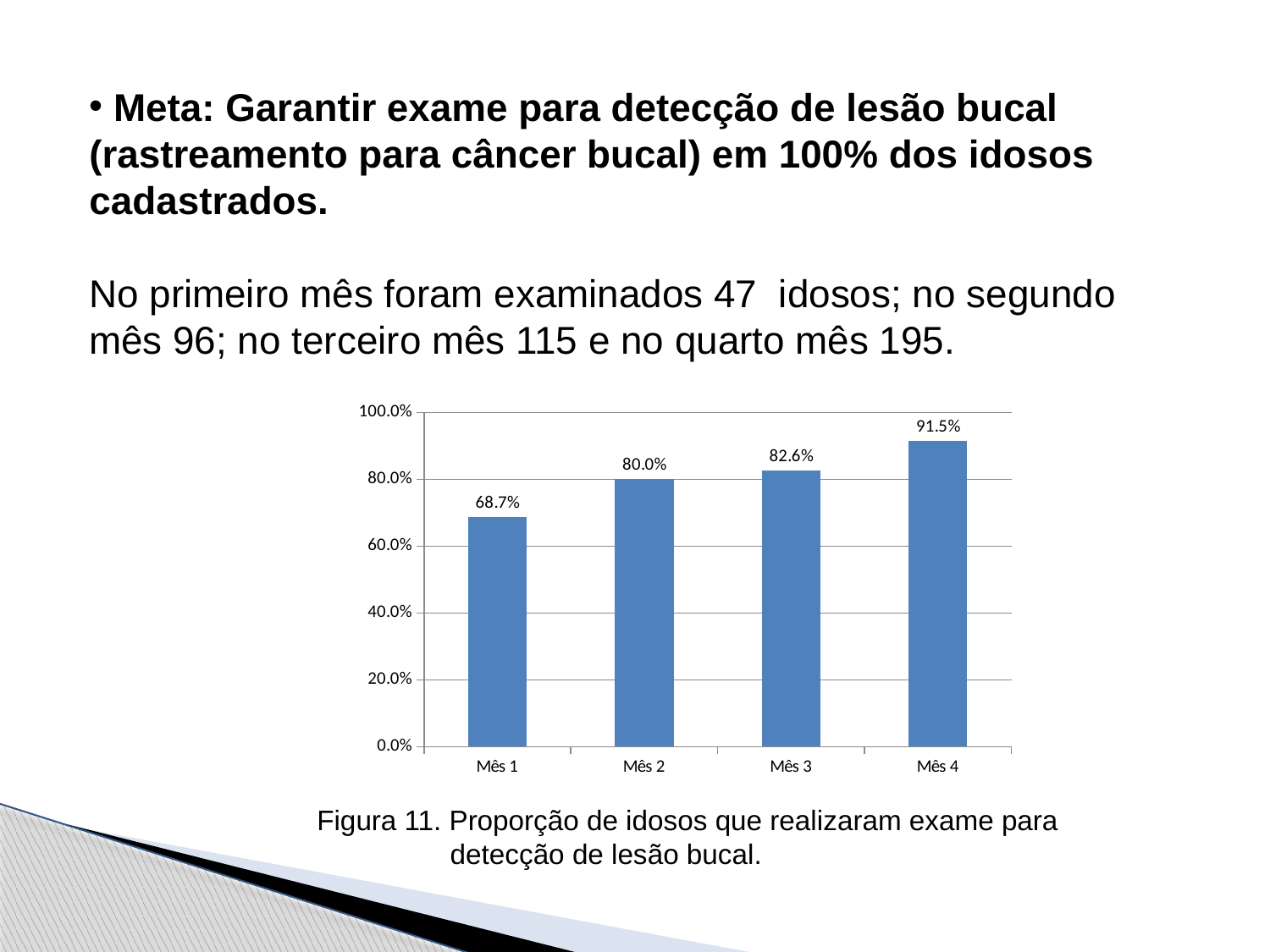
What is the value for Mês 2? 80.0% What kind of chart is shown on the slide? Bar chart What is the difference between the values for Mês 4 and Mês 1? 22.8% What is the value for Mês 4? 91.5% What is the value for Mês 1? 68.7% Which month has the lowest value? Mês 1 Do the values rise or fall from Mês 1 to Mês 4? Rise What is the difference between the values for Mês 3 and Mês 2? 2.6% Which month has the highest value? Mês 4 Which is larger, the value for Mês 2 or the value for Mês 4? Mês 4 What is the value for Mês 3? 82.6% How many months are shown on the x axis? 4